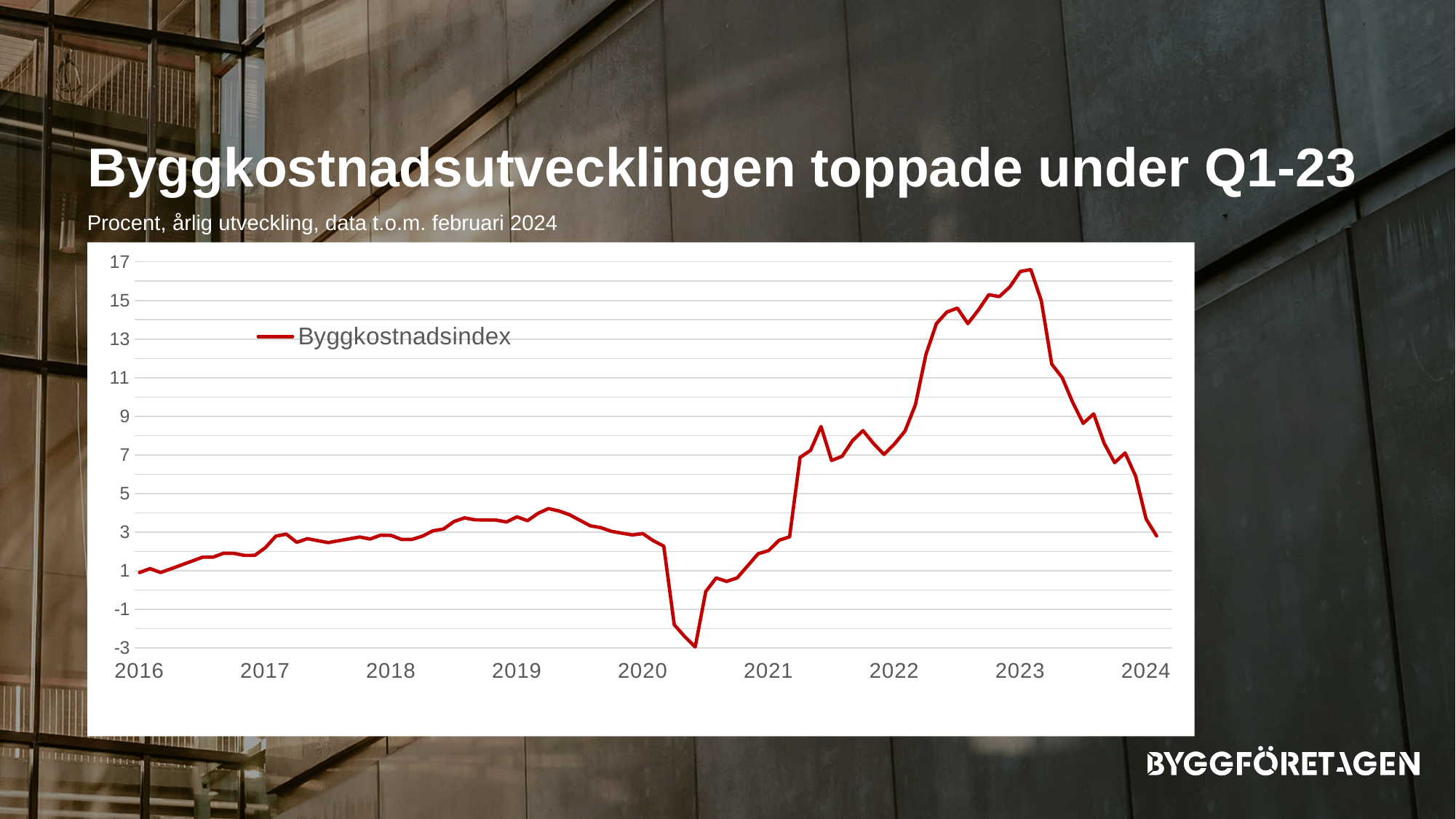
What is the name of the series shown in the legend? Byggkostnadsindex In which year does the Byggkostnadsindex line reach its highest point? 2023 How many series does the legend list? 1 What is the title of the chart on the slide? Byggkostnadsutvecklingen toppade under Q1-23 In which year does the Byggkostnadsindex line reach its lowest point? 2020 Is the peak value of Byggkostnadsindex in early 2023 greater or less than 15? greater Is the lowest value of Byggkostnadsindex in 2020 greater or less than -1? less Does the Byggkostnadsindex line rise or fall between early 2023 and 2024? fall What kind of chart is shown on the slide? line chart How many year labels are shown on the x axis? 9 Is the last plotted value of Byggkostnadsindex in 2024 greater or less than 5? less